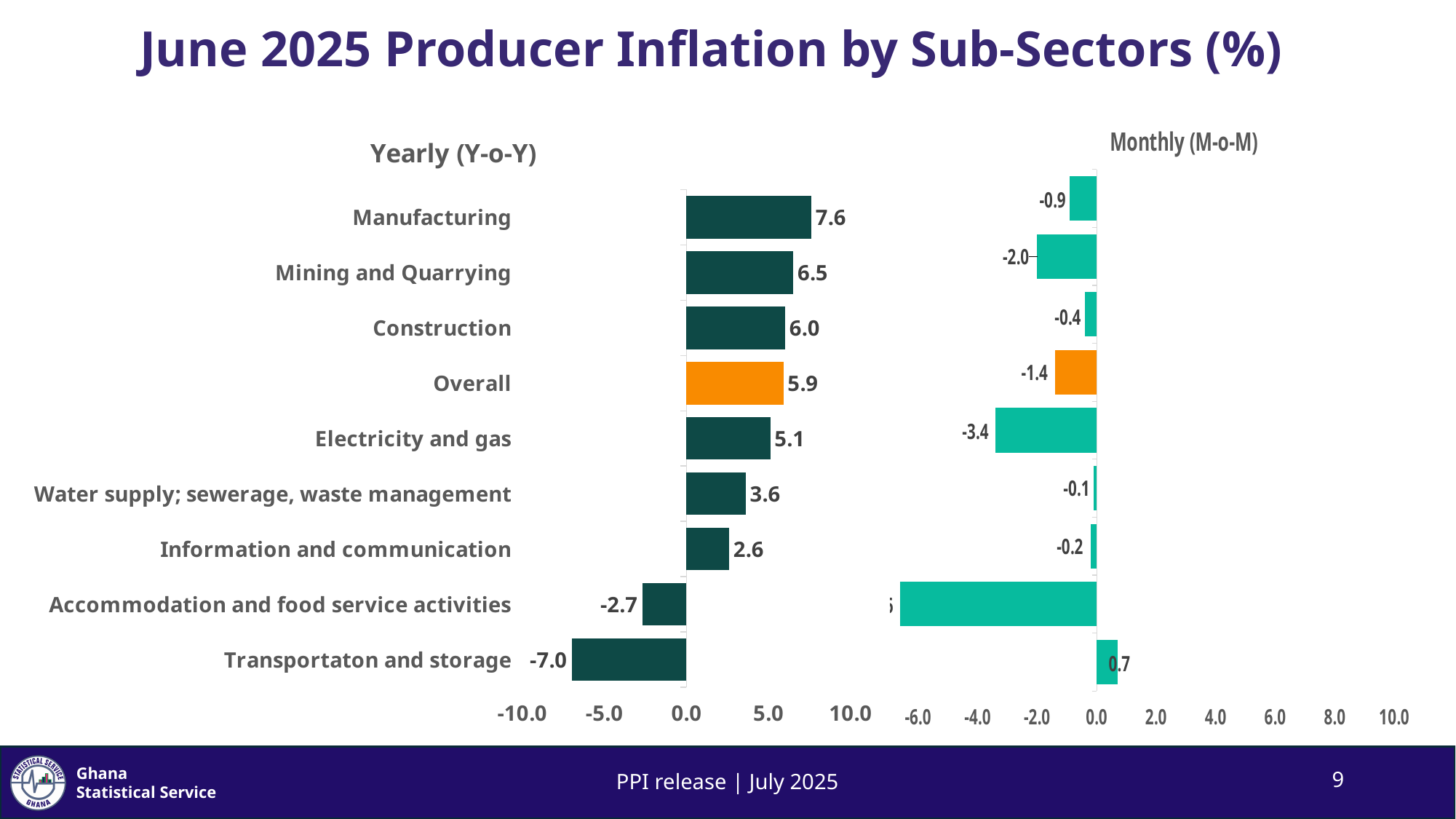
In the Yearly (Y-o-Y) chart, what is the value for Manufacturing? 7.6 In the Yearly (Y-o-Y) chart, which is larger, Construction or Electricity and gas? Construction In the Yearly (Y-o-Y) chart, which sub-sector has the lowest value? Transportaton and storage In the Yearly (Y-o-Y) chart, what is the difference between Manufacturing and Mining and Quarrying? 1.1 In the Monthly (M-o-M) chart, is the value for Accommodation and food service activities greater or less than -4.0? less In the Yearly (Y-o-Y) chart, which sub-sector has the highest value? Manufacturing In the Monthly (M-o-M) chart, what is the value for Electricity and gas? -3.4 In the Monthly (M-o-M) chart, which category has the highest value? Transportaton and storage In the Yearly (Y-o-Y) chart, what is the value for Transportaton and storage? -7.0 What kind of chart is the Monthly (M-o-M) chart? bar chart In the Monthly (M-o-M) chart, what is the value for Overall? -1.4 How many categories are shown in the Yearly (Y-o-Y) chart? 9